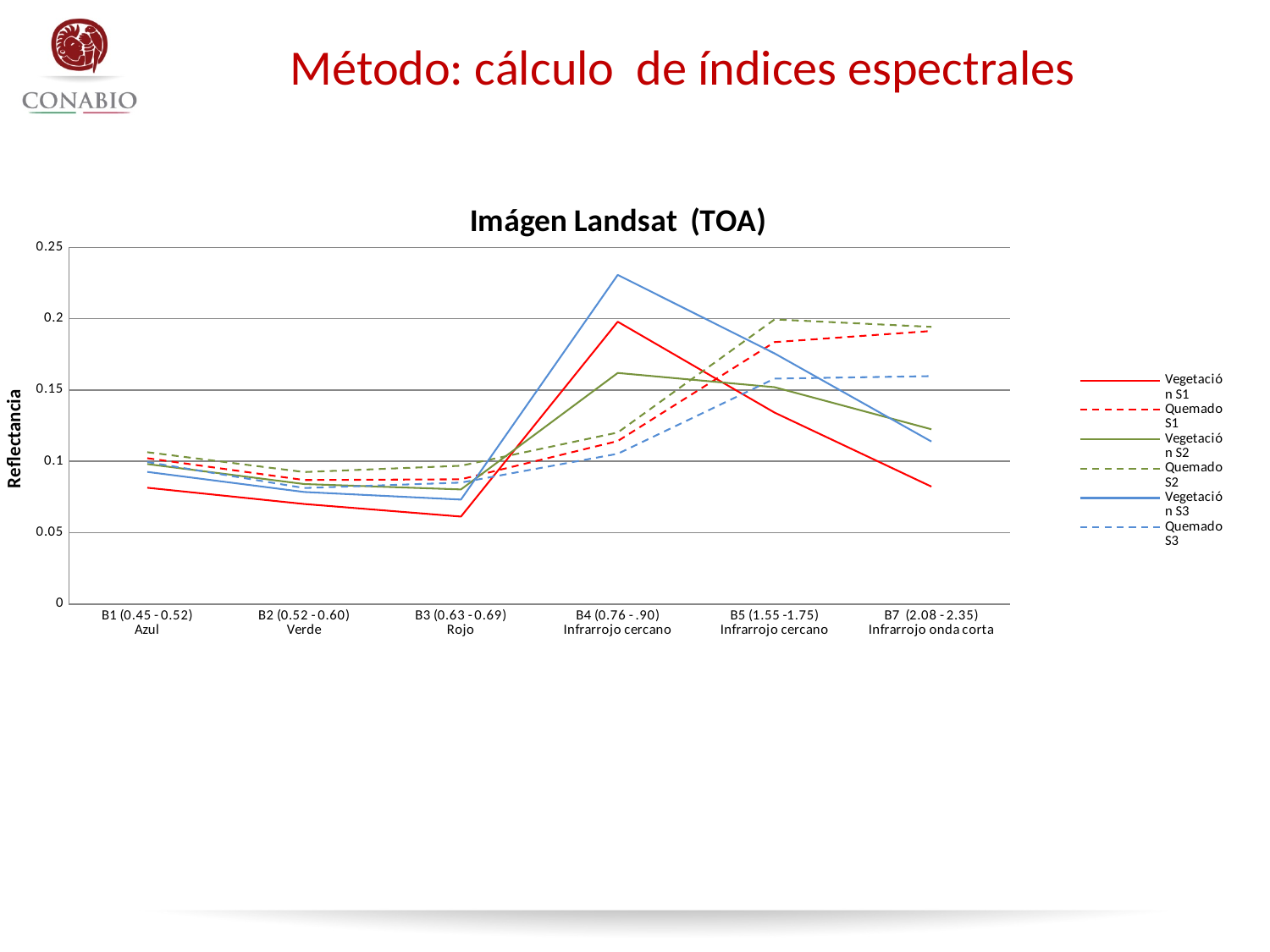
Is the value for Vegetación S3 at B4 (0.76 - .90) greater or less than 0.2? greater At B7 (2.08 - 2.35) Infrarrojo onda corta, which is larger: Quemado S1 or Vegetación S1? Quemado S1 How many Landsat bands (categories) are shown on the x axis? 6 What is the title of the chart? Imágen Landsat (TOA) Does the Quemado S1 line rise or fall from B3 to B7? rises Which series has the highest value at B4 (0.76 - .90) Infrarrojo cercano? Vegetación S3 What kind of chart is shown on the slide? line chart How many series does the legend list? 6 Is the value for Quemado S2 at B5 (1.55 - 1.75) greater or less than 0.15? greater Which series has the lowest value at B3 (0.63 - 0.69) Rojo? Vegetación S1 Is the value for Vegetación S1 at B3 (0.63 - 0.69) Rojo greater or less than 0.1? less Does the Vegetación S1 line rise or fall from B4 to B7? falls